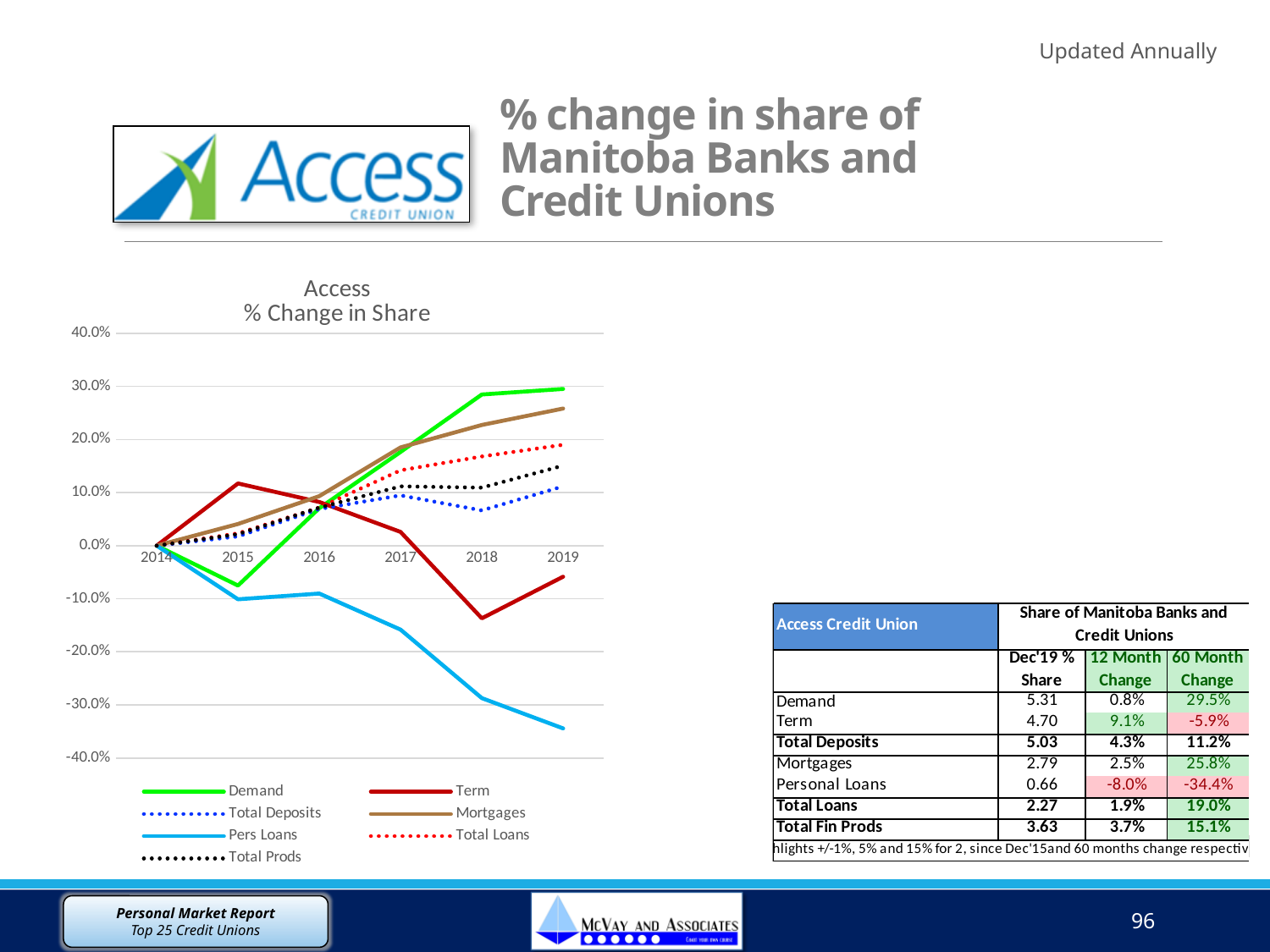
In the "Access % Change in Share" chart, which is larger in 2015: Term or Demand? Term In the "Access % Change in Share" chart, which series has the highest value in 2019? Demand What colour is the Demand line in the "Access % Change in Share" chart? green In the "Access % Change in Share" chart, which series has the lowest value in 2019? Pers Loans In the "Access % Change in Share" chart, is the value for Pers Loans in 2019 greater or less than -30.0%? less In the "Access % Change in Share" chart, does the Pers Loans line rise or fall from 2014 to 2019? fall In the "Access % Change in Share" chart, which is larger in 2019: Mortgages or Total Loans? Mortgages How many years are shown on the x axis of the "Access % Change in Share" chart? 6 What kind of chart is the "Access % Change in Share" chart? line chart In the "Access % Change in Share" chart, is the value for Demand in 2019 greater or less than 20.0%? greater In the "Access % Change in Share" chart, is the value for Term in 2018 greater or less than -10.0%? less How many series does the legend of the "Access % Change in Share" chart list? 7